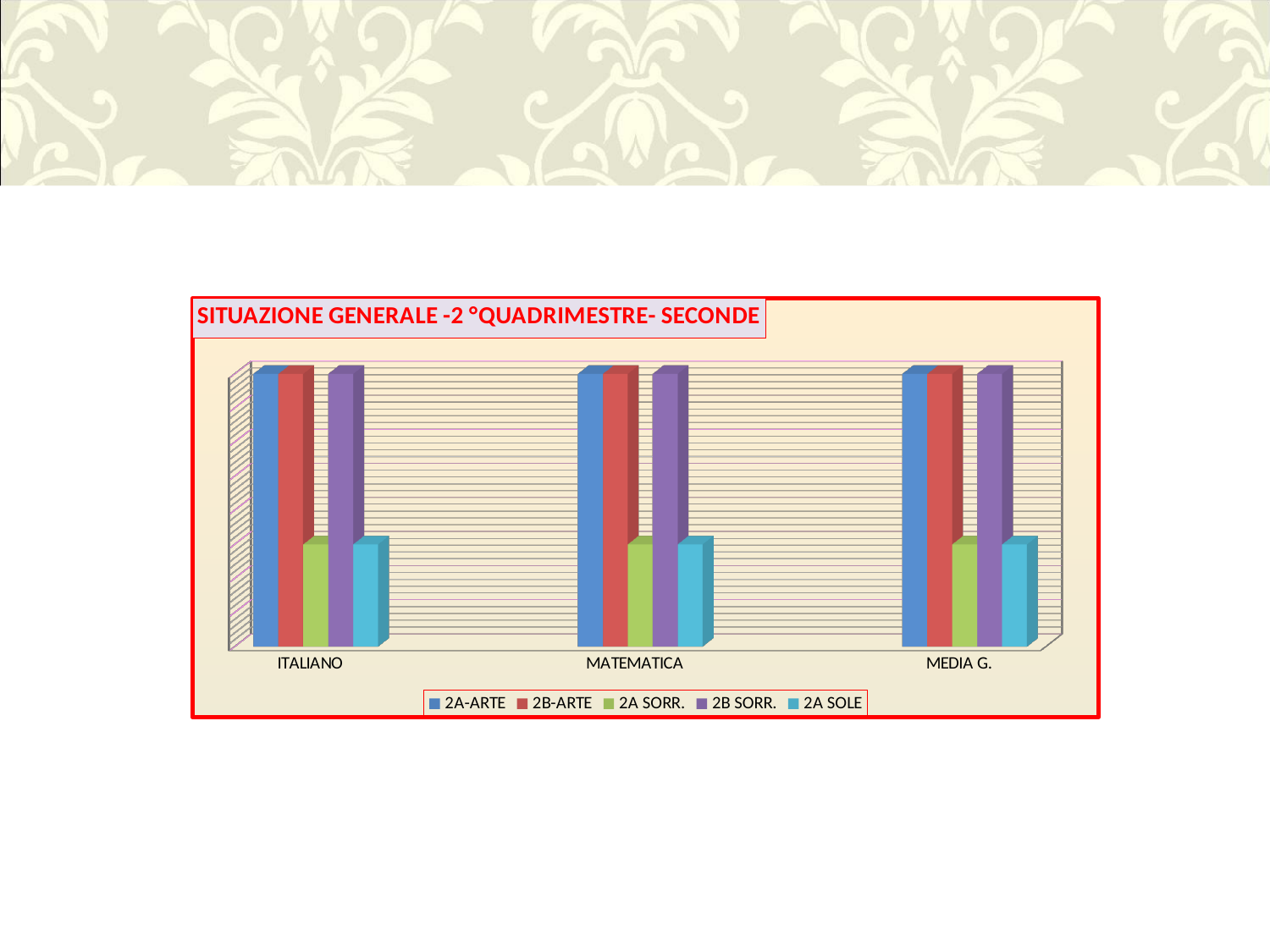
Which series is shown in green in the chart's legend? 2A SORR. In the MEDIA G. category, which is larger: the bar for 2A SOLE or the bar for 2B-ARTE? 2B-ARTE How many series does the chart's legend list? 5 How many categories are shown on the x axis of the chart? 3 What is the title of the chart? SITUAZIONE GENERALE -2 °QUADRIMESTRE- SECONDE In the MATEMATICA category, which is larger: the bar for 2B SORR. or the bar for 2A SOLE? 2B SORR. In the ITALIANO category, which is larger: the bar for 2A SORR. or the bar for 2B-ARTE? 2B-ARTE What is the label of the third category on the x axis of the chart? MEDIA G. What kind of chart is shown on the slide? bar chart